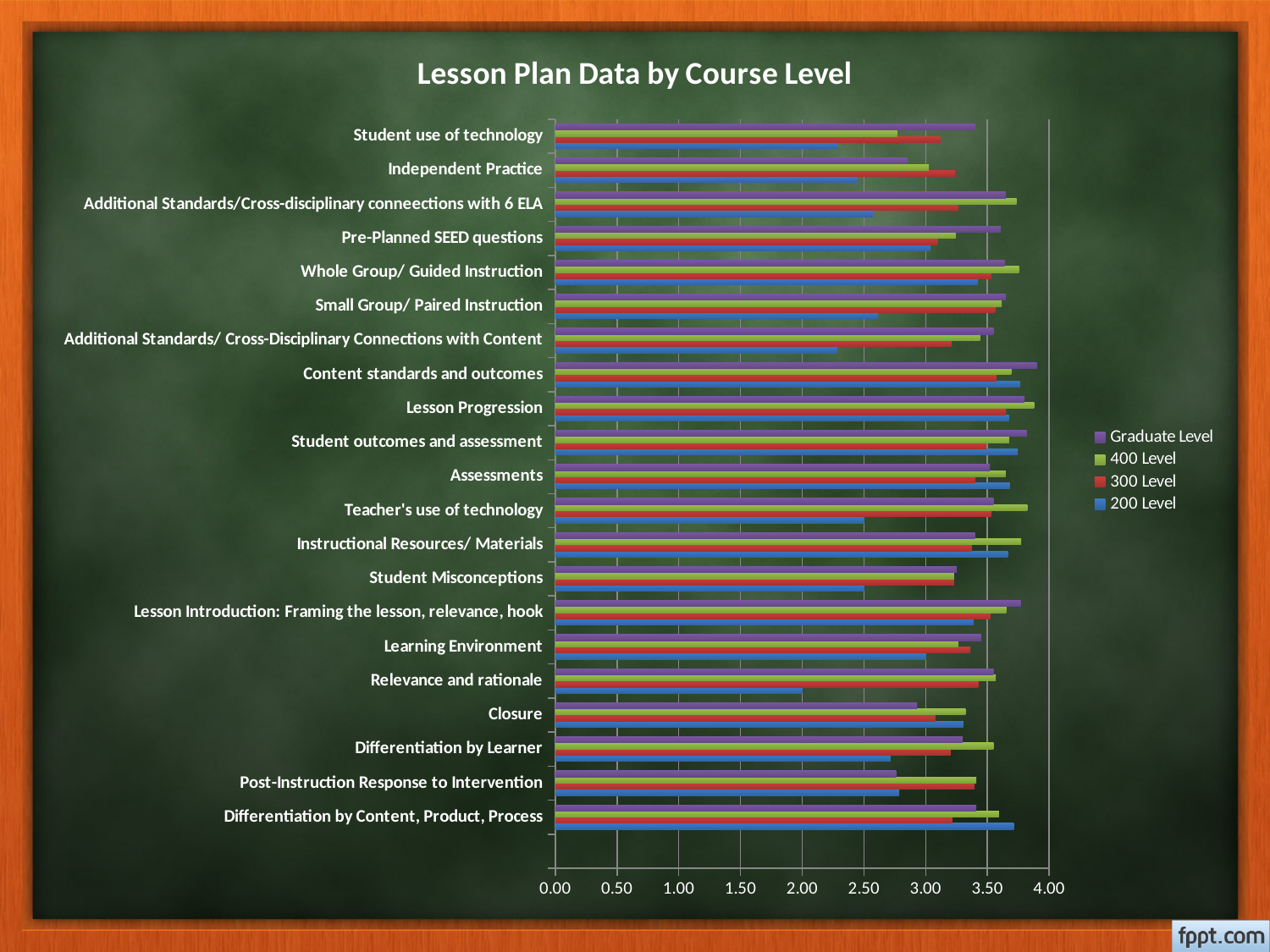
How many series does the legend list? 4 Is the 200 Level value for Student use of technology greater or less than 2.50? less For Relevance and rationale, which is larger: the 200 Level value or the Graduate Level value? Graduate Level What is the title of the chart? Lesson Plan Data by Course Level Is the 200 Level value for Differentiation by Content, Product, Process greater or less than 3.50? greater Which series is listed first in the legend? Graduate Level For Student use of technology, which is larger: the 200 Level value or the 300 Level value? 300 Level Is the Graduate Level value for Post-Instruction Response to Intervention greater or less than 3.00? less For Relevance and rationale, which course level has the lowest value? 200 Level What type of chart is shown on the slide? Bar chart How many categories are plotted on the chart? 21